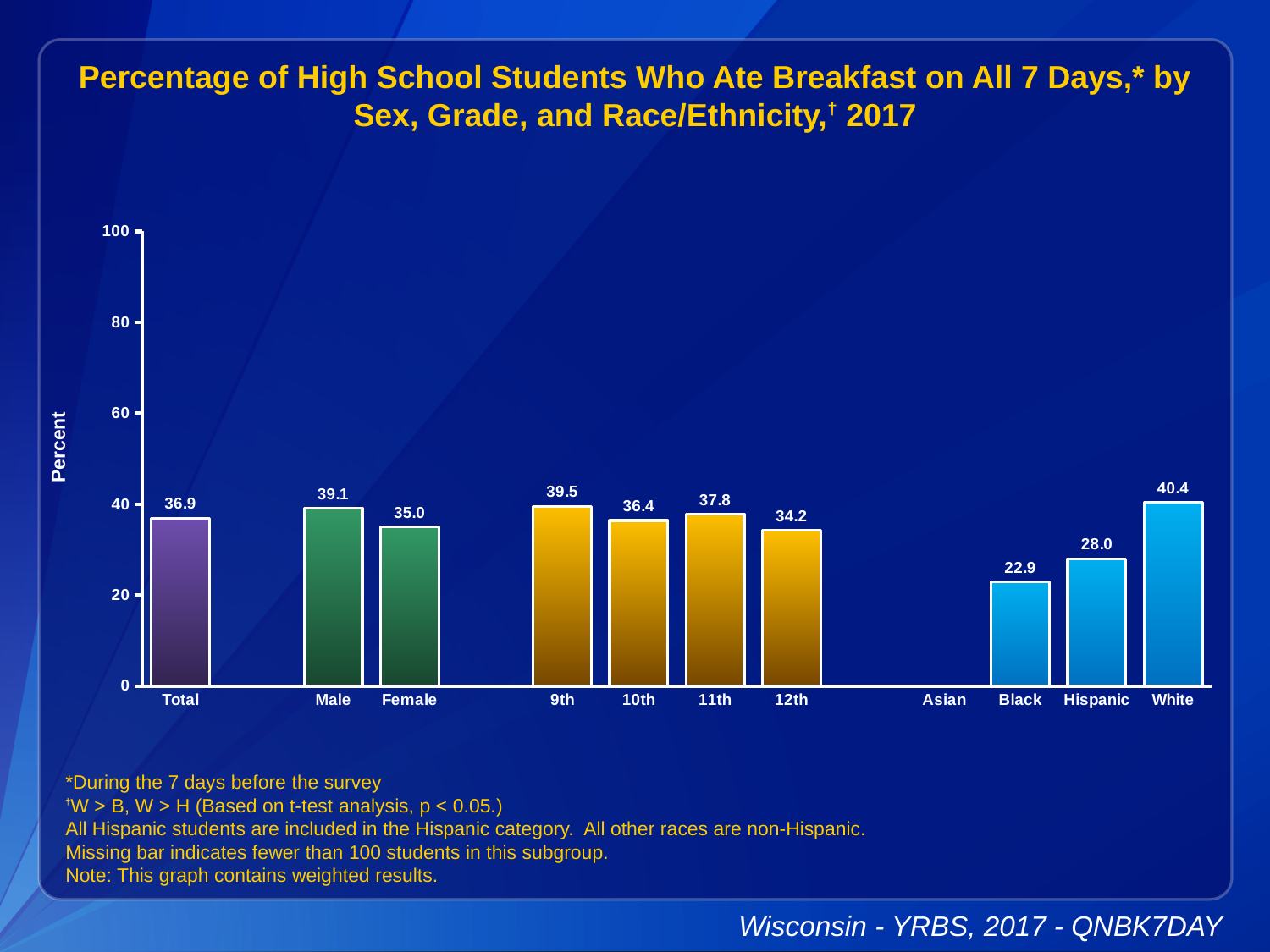
What is the value for Female? 35.0 Is the value for Hispanic greater or less than 40? less Which category has the highest value? White Which is larger, the value for 9th or the value for 12th? 9th Which category with a bar has the lowest value? Black Which category has no bar shown? Asian What is the difference between the values for Male and Female? 4.1 What is the value for Black? 22.9 What is the value for Total? 36.9 How many categories are labeled on the x axis? 11 What kind of chart is shown? bar chart